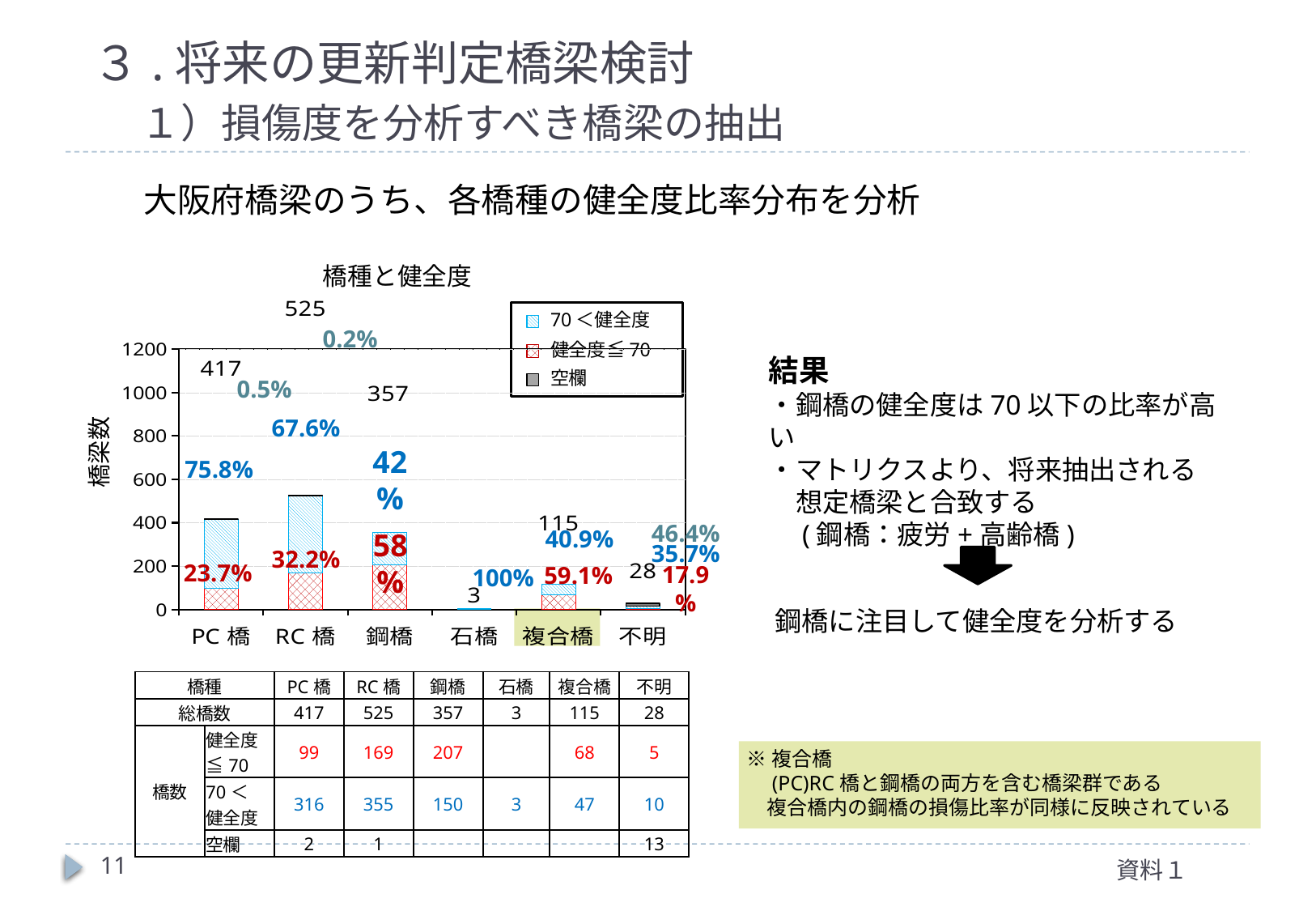
What is the title of the chart? 橋種と健全度 What is the total number of bridges labeled above the 鋼橋 bar? 357 What percentage is labeled in blue (70＜健全度) for the PC橋 bar? 75.8% Which bridge type has the lowest total bar in the chart? 石橋 Which bridge type has the highest total bar in the chart? RC橋 How many bridge-type categories are shown on the x axis of the chart? 6 What is the total number of bridges labeled above the RC橋 bar? 525 How many series does the chart legend list? 3 What type of chart is shown on the slide? bar chart Which is larger, the total for 複合橋 or the total for 不明? 複合橋 What is the difference between the total labeled for PC橋 and the total labeled for 鋼橋? 60 What percentage is labeled in red (健全度≦70) for the 鋼橋 bar? 58%